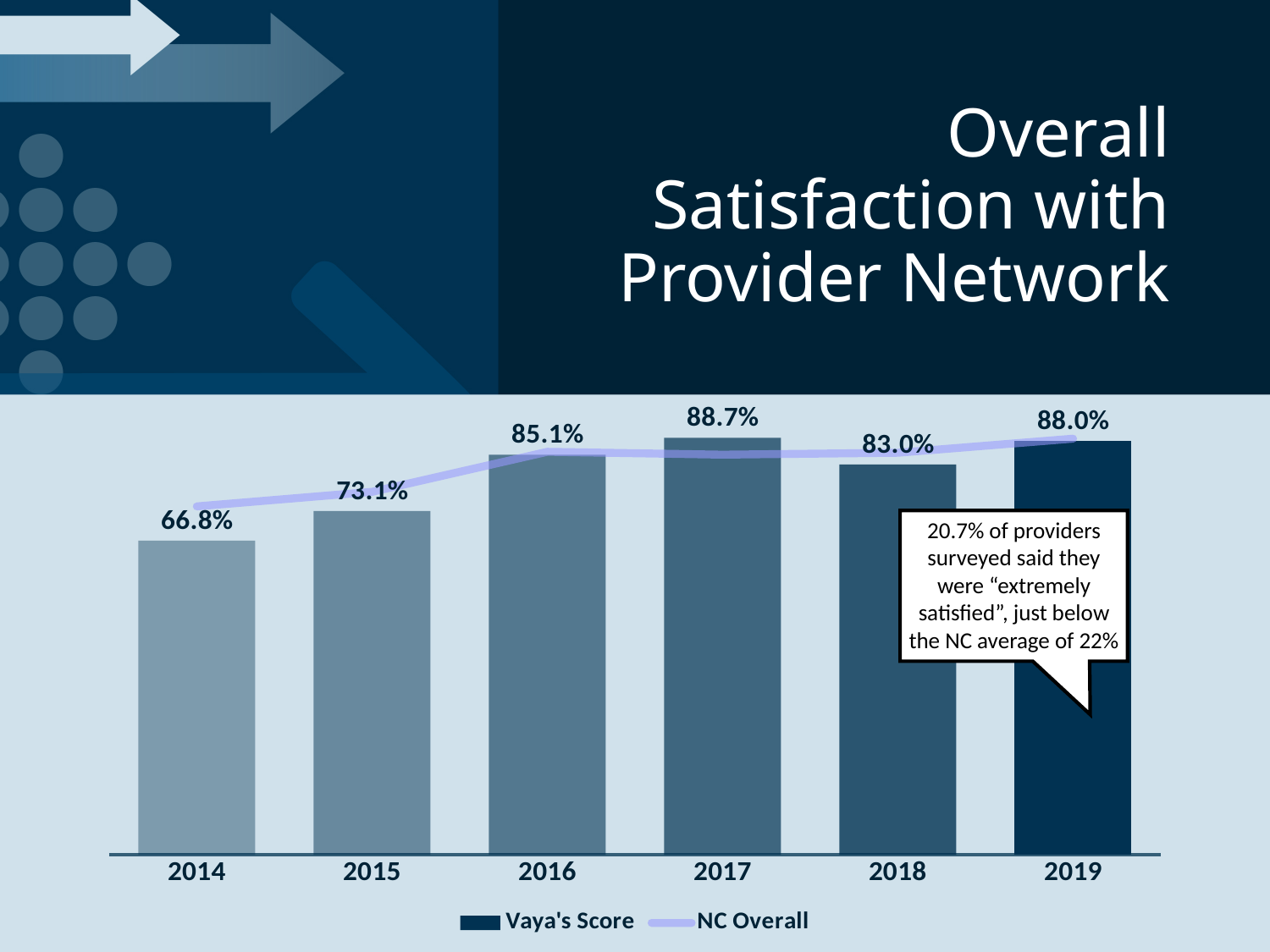
Which series is shown as a line rather than bars? NC Overall How many years are shown on the x axis? 6 How many series does the legend list? 2 Which year has the lowest Vaya's Score? 2014 What is Vaya's Score for 2014? 66.8% Which year has the highest Vaya's Score? 2017 What kind of chart is used to show Vaya's Score? Bar chart What is Vaya's Score for 2019? 88.0% What is the difference between Vaya's Score in 2016 and 2015? 12.0% Which year has a higher Vaya's Score, 2018 or 2019? 2019 What is Vaya's Score for 2017? 88.7% What is the difference between Vaya's Score in 2017 and 2018? 5.7%